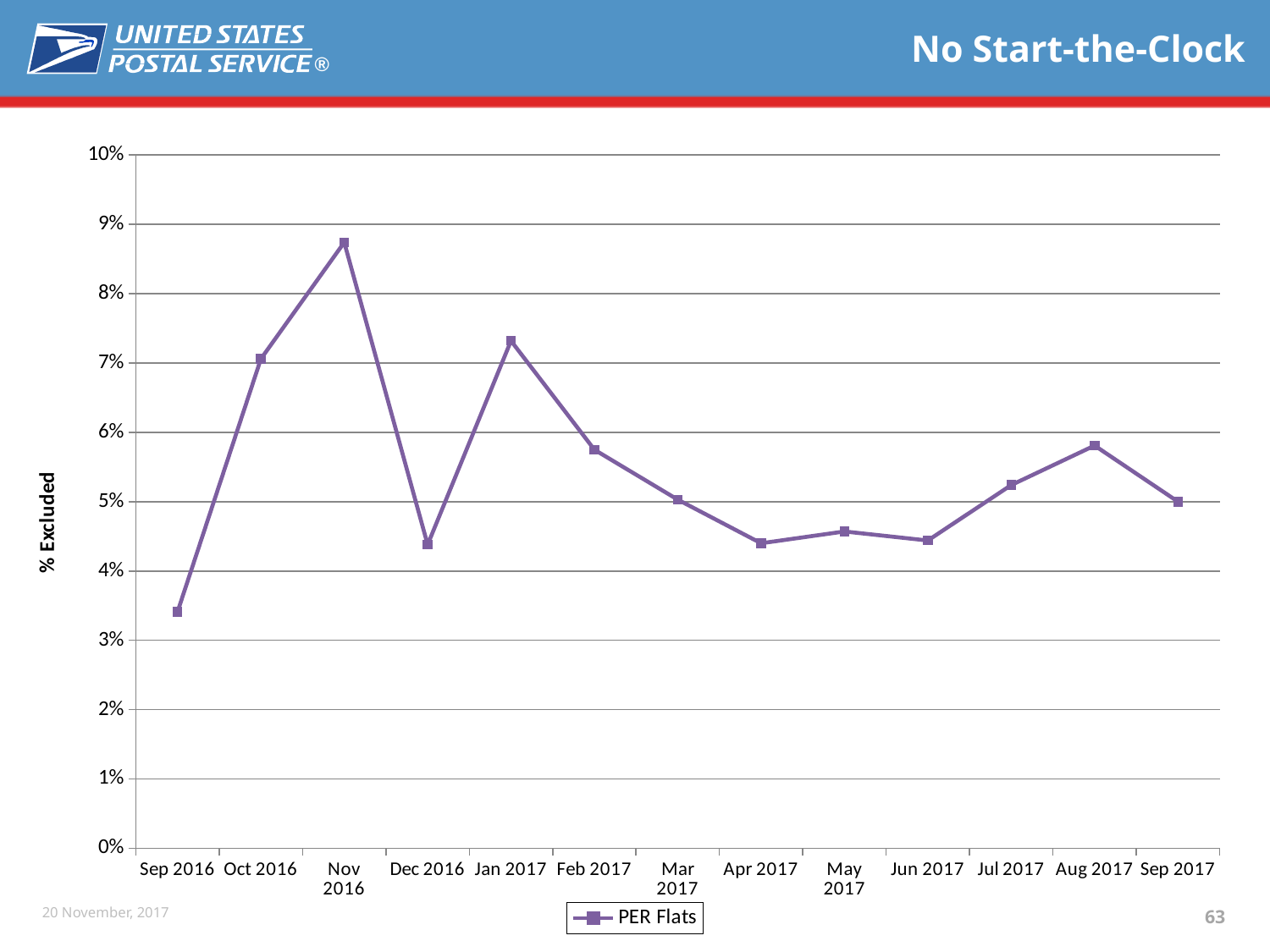
What kind of chart is shown on the slide? line chart Is the value for Sep 2016 greater or less than 4%? less Does the value rise or fall from Sep 2016 to Nov 2016? rise Is the value for Dec 2016 greater or less than 5%? less What is the label on the vertical axis? % Excluded How many series does the legend list? 1 What is the name of the series shown in the legend? PER Flats Is the value for Nov 2016 greater or less than 8%? greater How many months are plotted along the x axis? 13 Which is larger, the value for Oct 2016 or the value for Feb 2017? Oct 2016 Which month has the highest value for PER Flats? Nov 2016 Which month has the lowest value for PER Flats? Sep 2016